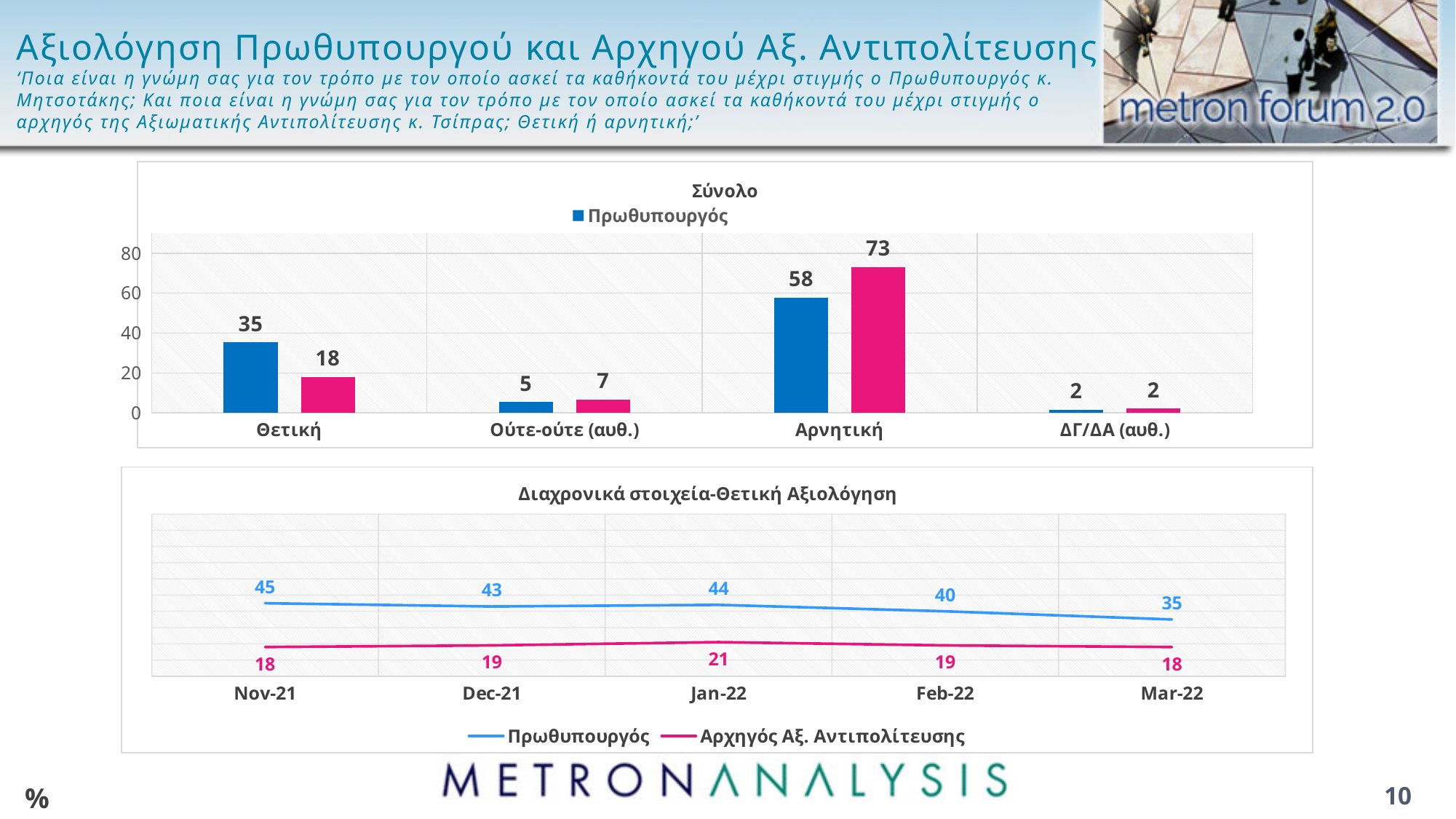
What kind of chart is the top chart titled 'Σύνολο'? Bar chart In the top chart titled 'Σύνολο', what is the value of the blue 'Πρωθυπουργός' bar for 'Αρνητική'? 58 How many series does the legend of the bottom chart titled 'Διαχρονικά στοιχεία-Θετική Αξιολόγηση' list? 2 In the top chart titled 'Σύνολο', how many categories are shown on the x axis? 4 In the bottom chart titled 'Διαχρονικά στοιχεία-Θετική Αξιολόγηση', what is the value for 'Πρωθυπουργός' in Jan-22? 44 In the top chart titled 'Σύνολο', what is the difference between the pink bar and the blue bar for 'Θετική'? 17 In the bottom chart titled 'Διαχρονικά στοιχεία-Θετική Αξιολόγηση', does the 'Πρωθυπουργός' line rise or fall from Nov-21 to Mar-22? Fall In the bottom chart titled 'Διαχρονικά στοιχεία-Θετική Αξιολόγηση', in which month does 'Αρχηγός Αξ. Αντιπολίτευσης' reach its highest value? Jan-22 In the top chart titled 'Σύνολο', what is the value of the pink bar for 'Αρνητική'? 73 In the top chart titled 'Σύνολο', which category has the highest value for the blue 'Πρωθυπουργός' series? Αρνητική In the top chart titled 'Σύνολο', what is the value of the blue 'Πρωθυπουργός' bar for 'Θετική'? 35 In the bottom chart titled 'Διαχρονικά στοιχεία-Θετική Αξιολόγηση', what is the value for 'Αρχηγός Αξ. Αντιπολίτευσης' in Feb-22? 19